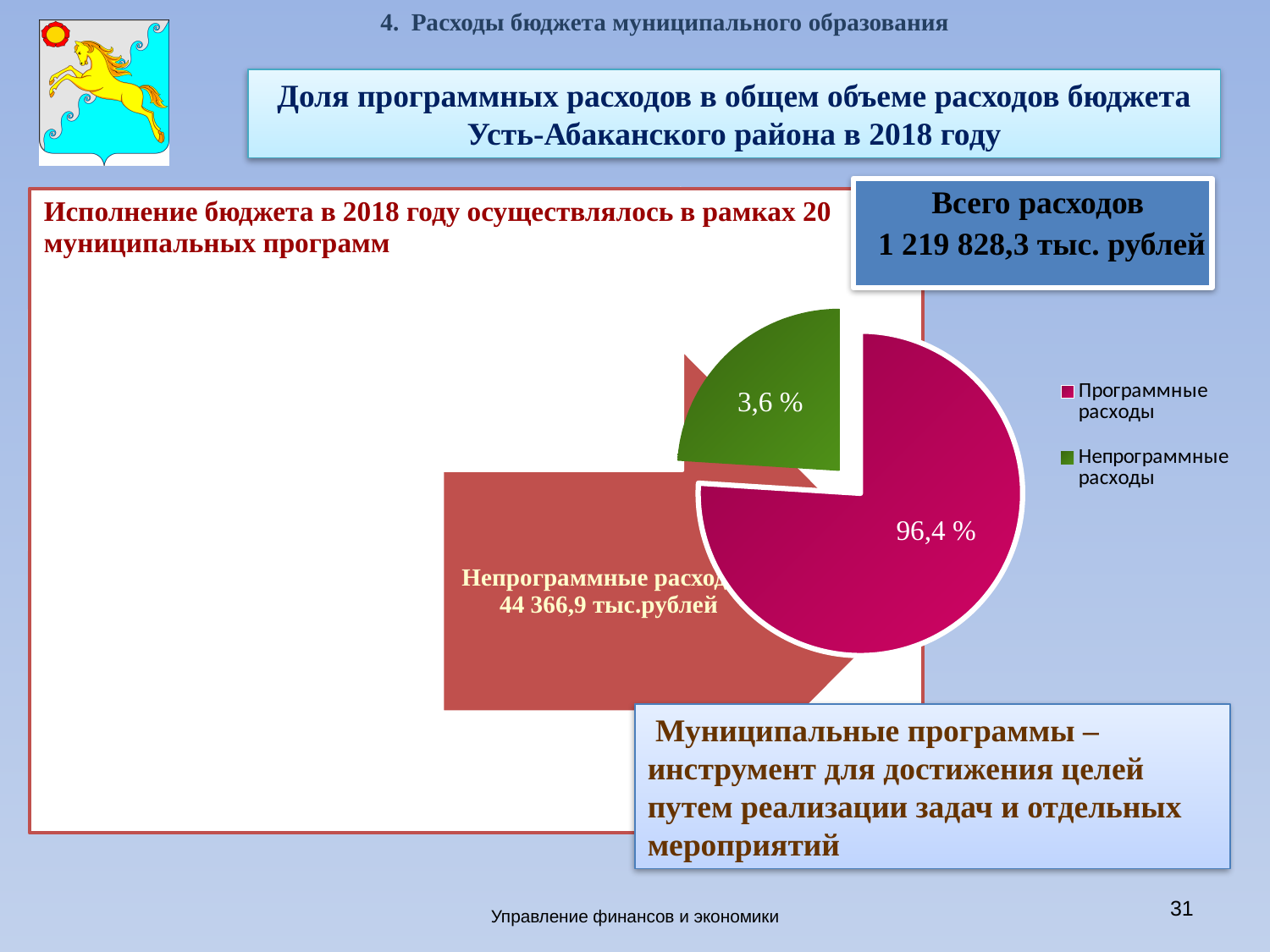
What kind of chart is shown on the slide? pie chart What share of the pie does "Непрограммные расходы" have? 3,6 % What is the difference in percentage points between the "Программные расходы" and "Непрограммные расходы" slices? 92,8 How many slices does the pie chart have? 2 How many entries does the legend of the pie chart list? 2 What colour is the "Непрограммные расходы" slice in the pie chart? green Which is larger in the pie chart: "Программные расходы" or "Непрограммные расходы"? Программные расходы What colour is the "Программные расходы" slice in the pie chart? magenta What share of the pie does "Программные расходы" have? 96,4 % Which slice of the pie chart is the largest? Программные расходы Which slice of the pie chart is the smallest? Непрограммные расходы